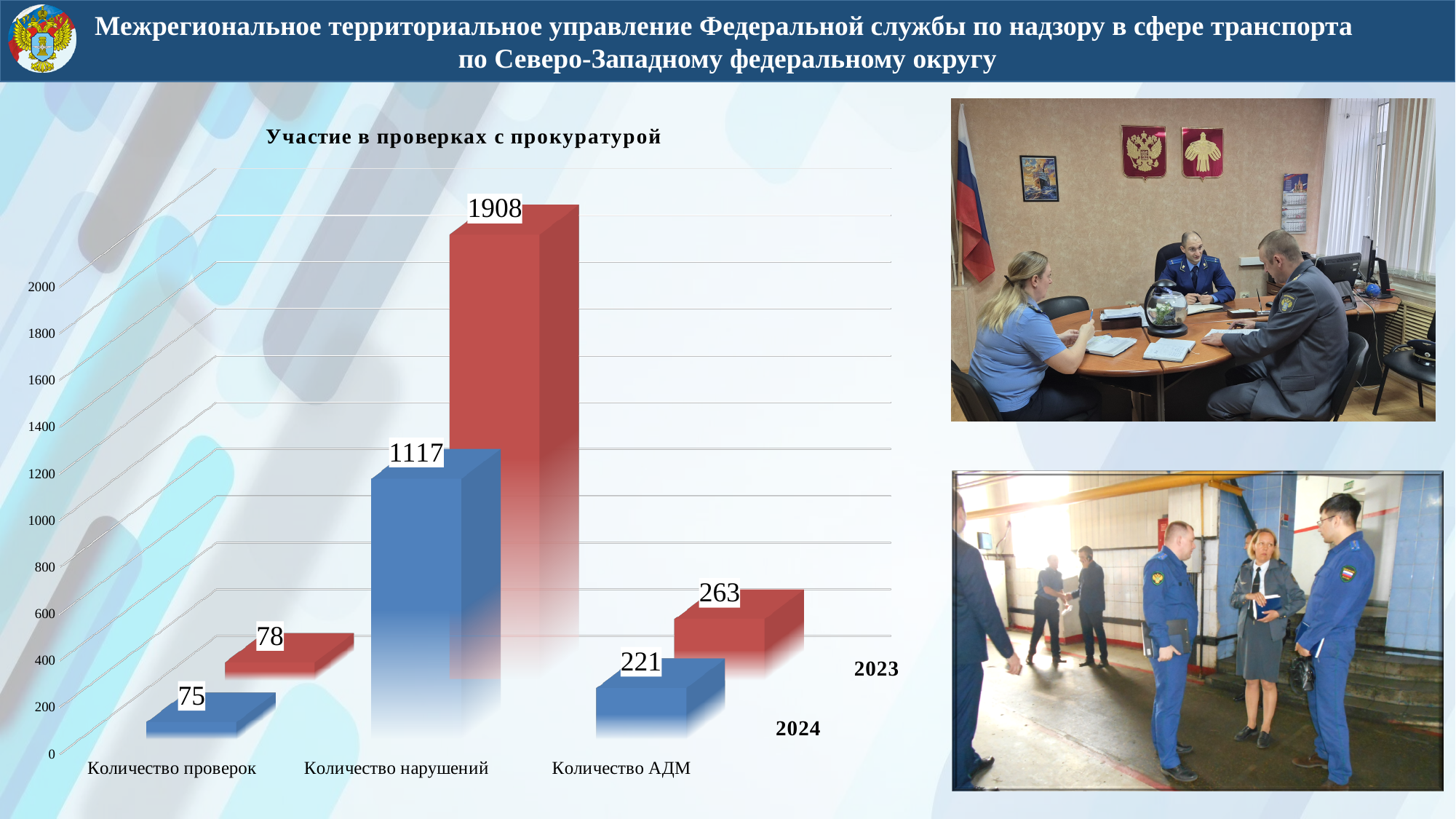
How many years (series) does the chart compare? 2 What is the value for Количество АДМ in 2023? 263 Which category has the lowest value in 2024? Количество проверок Which category has the highest value in 2023? Количество нарушений How many categories are shown on the x axis of the chart? 3 What is the title of the chart? Участие в проверках с прокуратурой What is the difference between the 2023 and 2024 values for Количество АДМ? 42 Which is larger for Количество АДМ: the 2023 value or the 2024 value? 2023 What is the difference between the 2023 and 2024 values for Количество нарушений? 791 What is the value for Количество нарушений in 2023? 1908 What is the value for Количество проверок in 2024? 75 What is the value for Количество нарушений in 2024? 1117